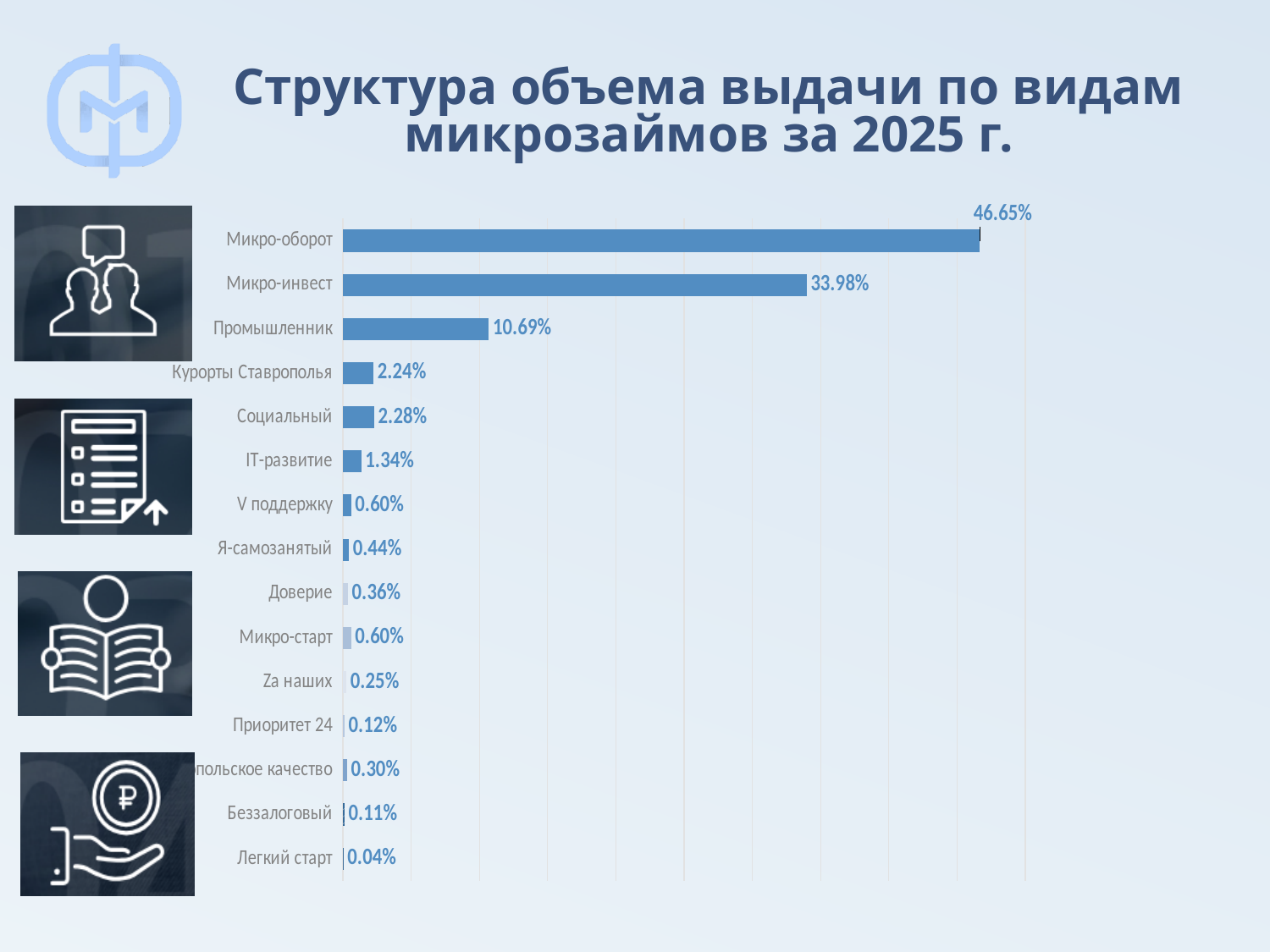
Which category has the highest value? Микро-оборот What is the value for IT-развитие? 1.34% Which is larger, the value for Социальный or the value for Курорты Ставрополья? Социальный What kind of chart is shown on the slide? Bar chart Which category has the lowest value? Легкий старт What is the value for Промышленник? 10.69% What is the value for Микро-оборот? 46.65% What is the difference between the values for Микро-оборот and Микро-инвест? 12.67% What is the value for Беззалоговый? 0.11% What is the value for Я-самозанятый? 0.44% How many categories are shown in the chart? 15 What is the title of the slide? Структура объема выдачи по видам микрозаймов за 2025 г.